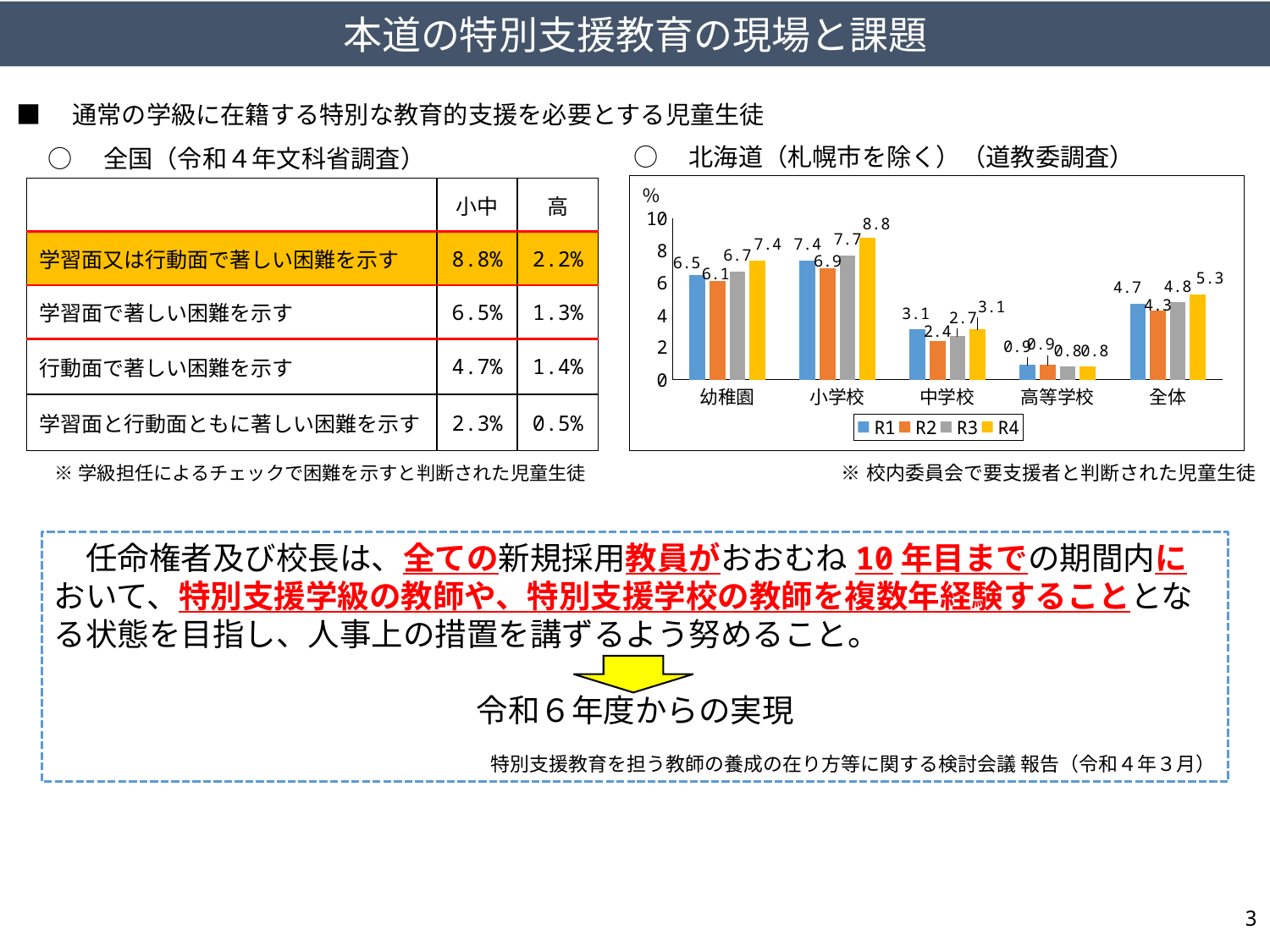
Which is larger for 全体: the R2 value or the R3 value? R3 What is the R4 value for 全体 in the chart? 5.3 Is the R4 value for 中学校 greater or less than 4? less Which category has the lowest R1 value in the chart? 高等学校 What is the difference between the R4 and R1 values for 小学校? 1.4 What is the R2 value for 中学校 in the chart? 2.4 What is the R1 value for 幼稚園 in the chart? 6.5 How many categories are shown on the x axis of the chart? 5 What type of chart is shown on the slide? bar chart Which category has the highest R4 value in the chart? 小学校 How many series does the chart legend list? 4 What is the R4 value for 小学校 in the chart? 8.8